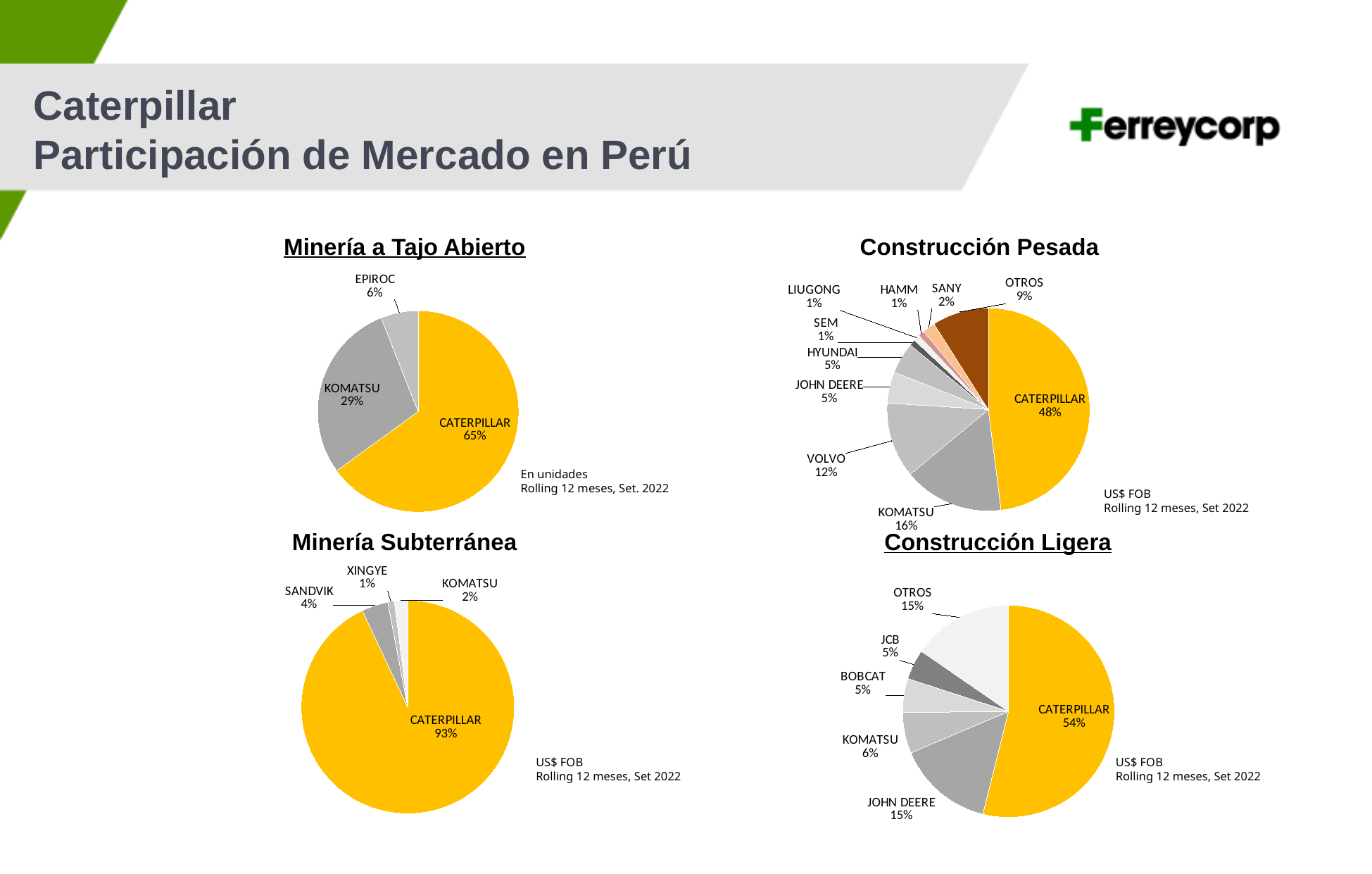
In the Construcción Pesada chart, what share does VOLVO hold? 12% In the Minería a Tajo Abierto chart, what is the difference between CATERPILLAR's and KOMATSU's shares? 36% In the Construcción Pesada chart, which is larger, KOMATSU or VOLVO? KOMATSU In the Minería Subterránea chart, what share does CATERPILLAR hold? 93% What type of chart is used for Construcción Ligera? Pie chart How many slices does the Construcción Pesada pie chart have? 10 In the Minería a Tajo Abierto chart, what share does KOMATSU hold? 29% In the Construcción Ligera chart, what is the difference between CATERPILLAR's and OTROS' shares? 39% In the Minería Subterránea chart, which brand has the smallest share? XINGYE In the Construcción Ligera chart, what share does JOHN DEERE hold? 15% In the Minería a Tajo Abierto chart, which brand has the largest share? CATERPILLAR How many slices does the Minería Subterránea pie chart have? 4